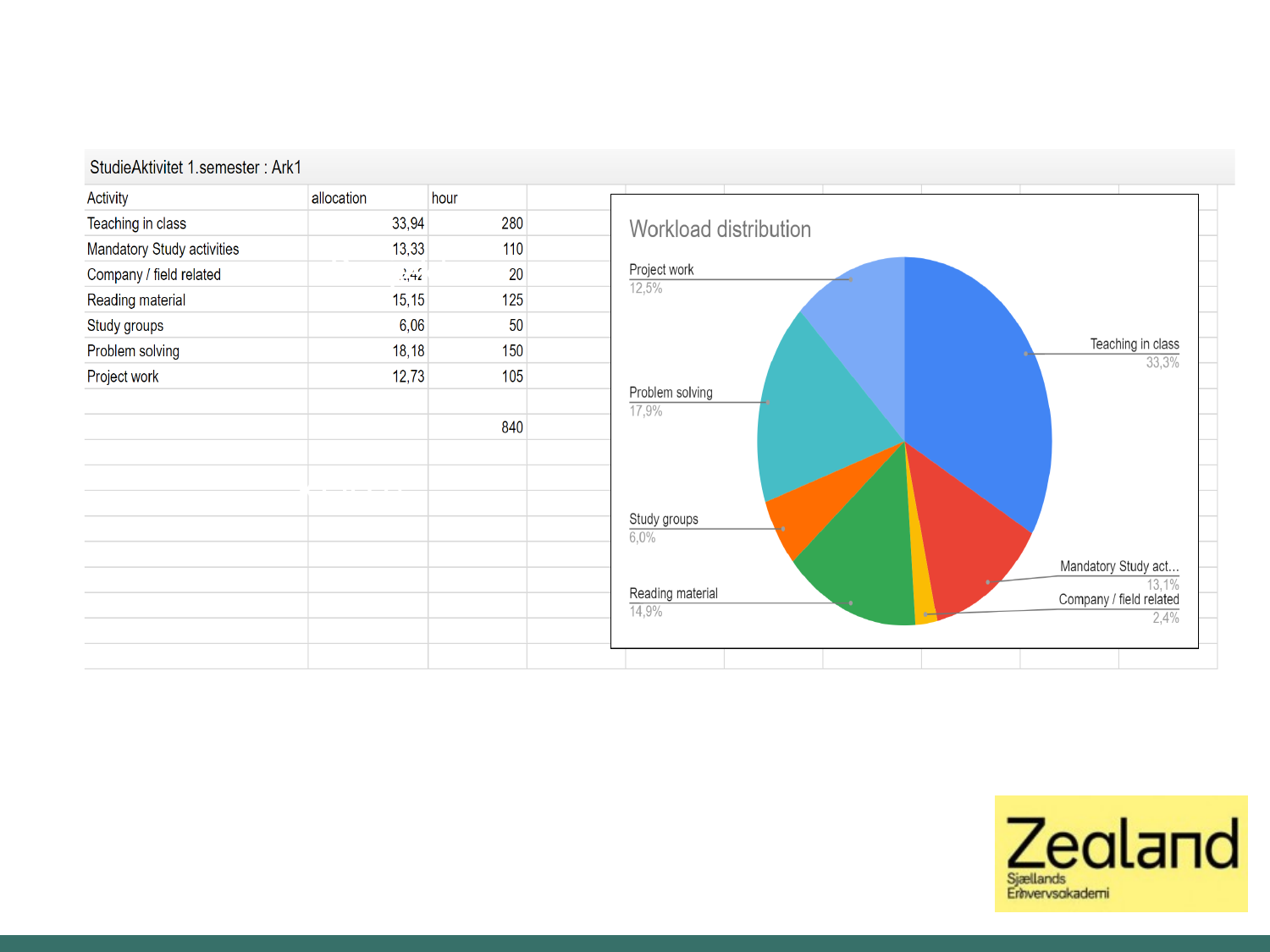
Which category has the smallest slice of the pie? Company / field related How many slices does the pie chart have? 7 Which is larger, the share for Problem solving or the share for Reading material? Problem solving What share of the pie does Reading material have? 14,9% What share of the pie does Company / field related have? 2,4% Which category has the largest slice of the pie? Teaching in class What share of the pie does Project work have? 12,5% What share of the pie does Problem solving have? 17,9% What is the title of the chart? Workload distribution What kind of chart is shown on the slide? pie chart What share of the pie does Teaching in class have? 33,3% What share of the pie does Study groups have? 6,0%